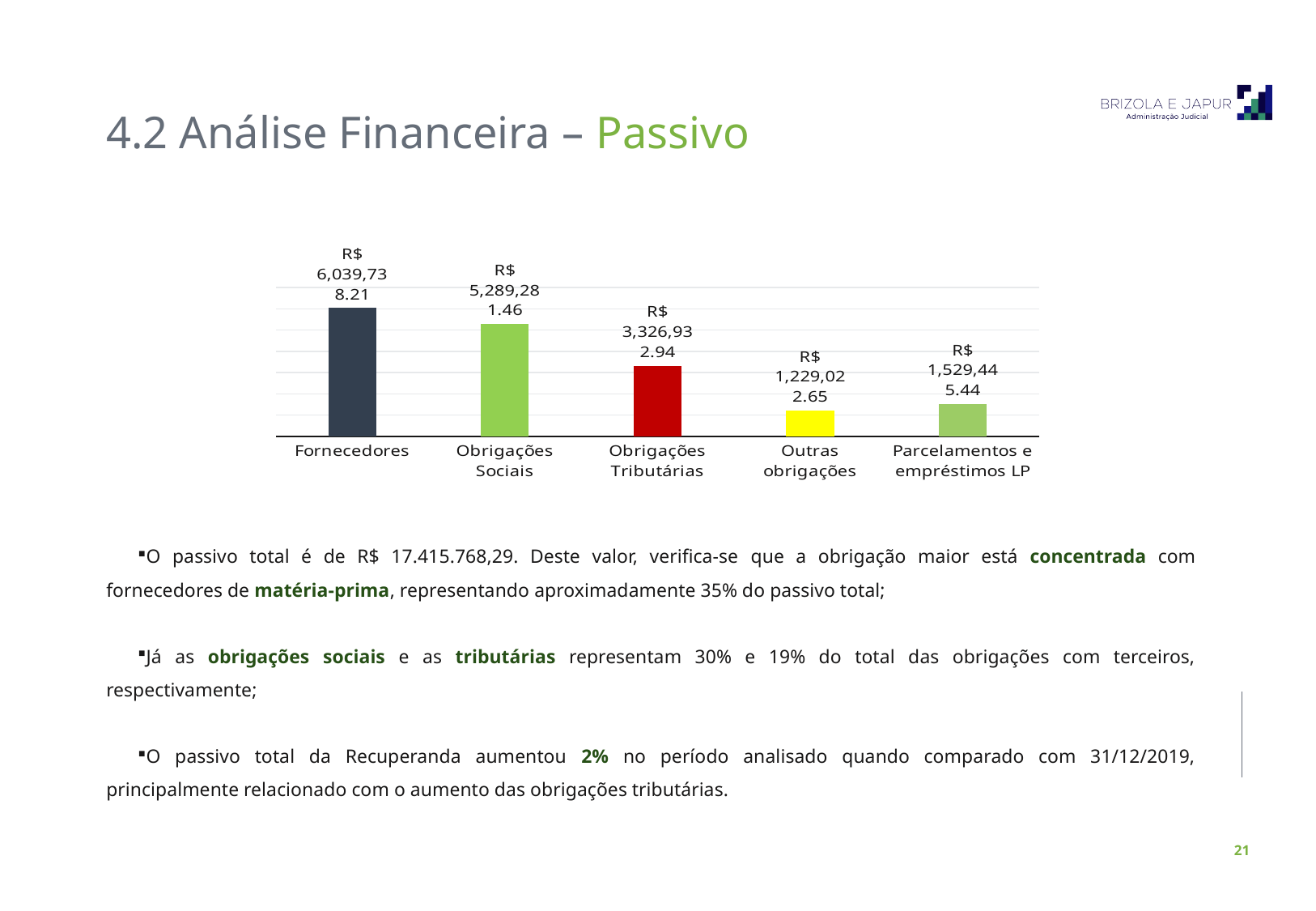
Which category has the highest value? Fornecedores Which is larger, Obrigações Tributárias or Parcelamentos e empréstimos LP? Obrigações Tributárias Which category has the lowest value? Outras obrigações What colour is the bar for Obrigações Tributárias? Red What is the value shown for Outras obrigações? R$ 1,229,022.65 What kind of chart is shown on the slide? Bar chart What is the value shown for Fornecedores? R$ 6,039,738.21 What is the value shown for Obrigações Sociais? R$ 5,289,281.46 What is the difference between the values for Fornecedores and Obrigações Sociais? R$ 750,456.75 What is the value shown for Obrigações Tributárias? R$ 3,326,932.94 How many categories are shown in the chart? 5 What is the value shown for Parcelamentos e empréstimos LP? R$ 1,529,445.44